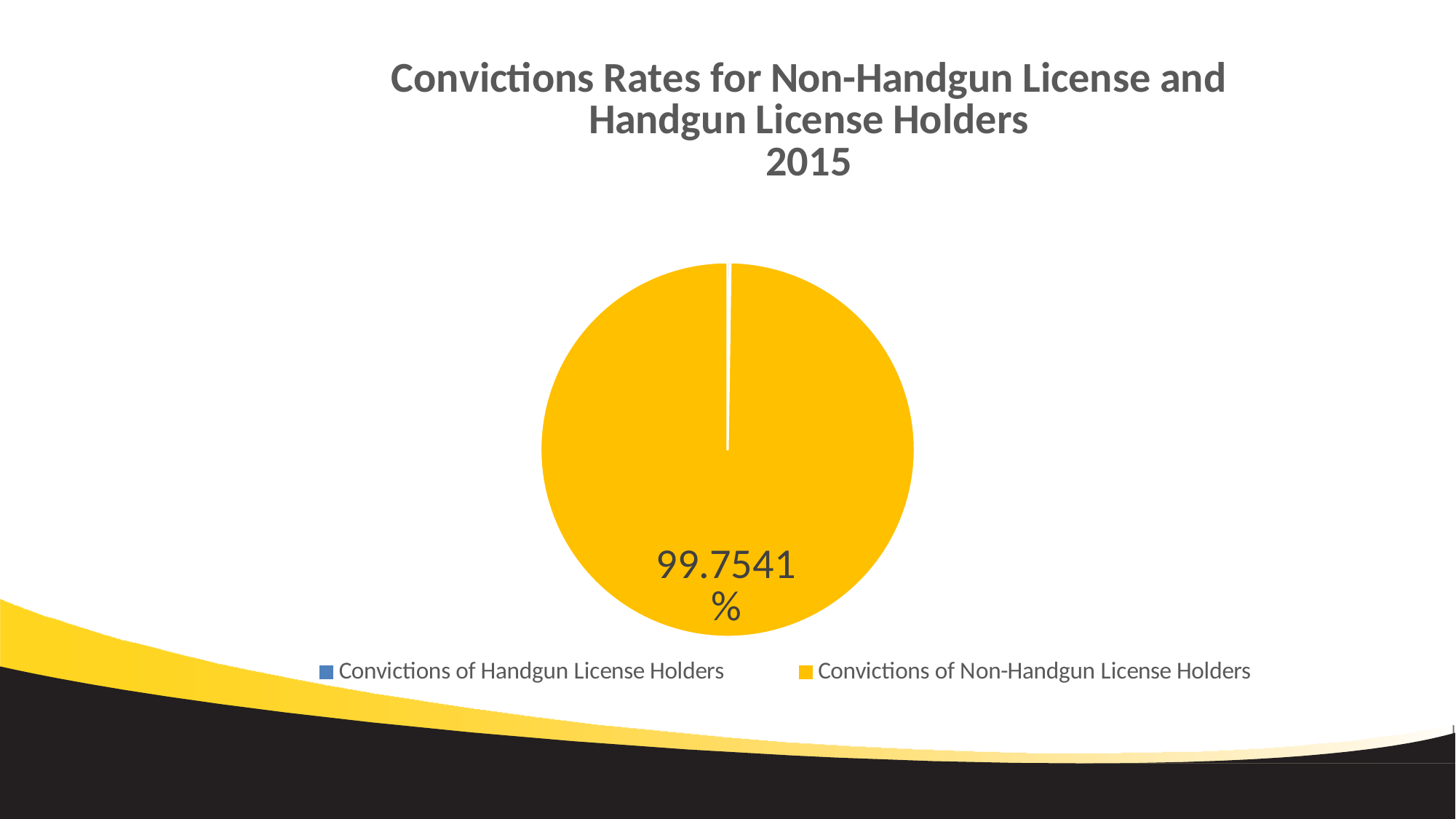
What kind of chart is shown on the slide? pie chart Which year does the chart title refer to? 2015 What colour represents Convictions of Non-Handgun License Holders in the chart? yellow What is the title of the chart? Convictions Rates for Non-Handgun License and Handgun License Holders 2015 Which category has the smallest slice of the pie? Convictions of Handgun License Holders What share of the pie does the Convictions of Non-Handgun License Holders slice take? 99.7541% How many categories does the pie chart have? 2 Which category has the largest slice of the pie? Convictions of Non-Handgun License Holders How many entries does the legend list? 2 Which is larger: Convictions of Handgun License Holders or Convictions of Non-Handgun License Holders? Convictions of Non-Handgun License Holders What percentage is shown for Convictions of Non-Handgun License Holders? 99.7541%